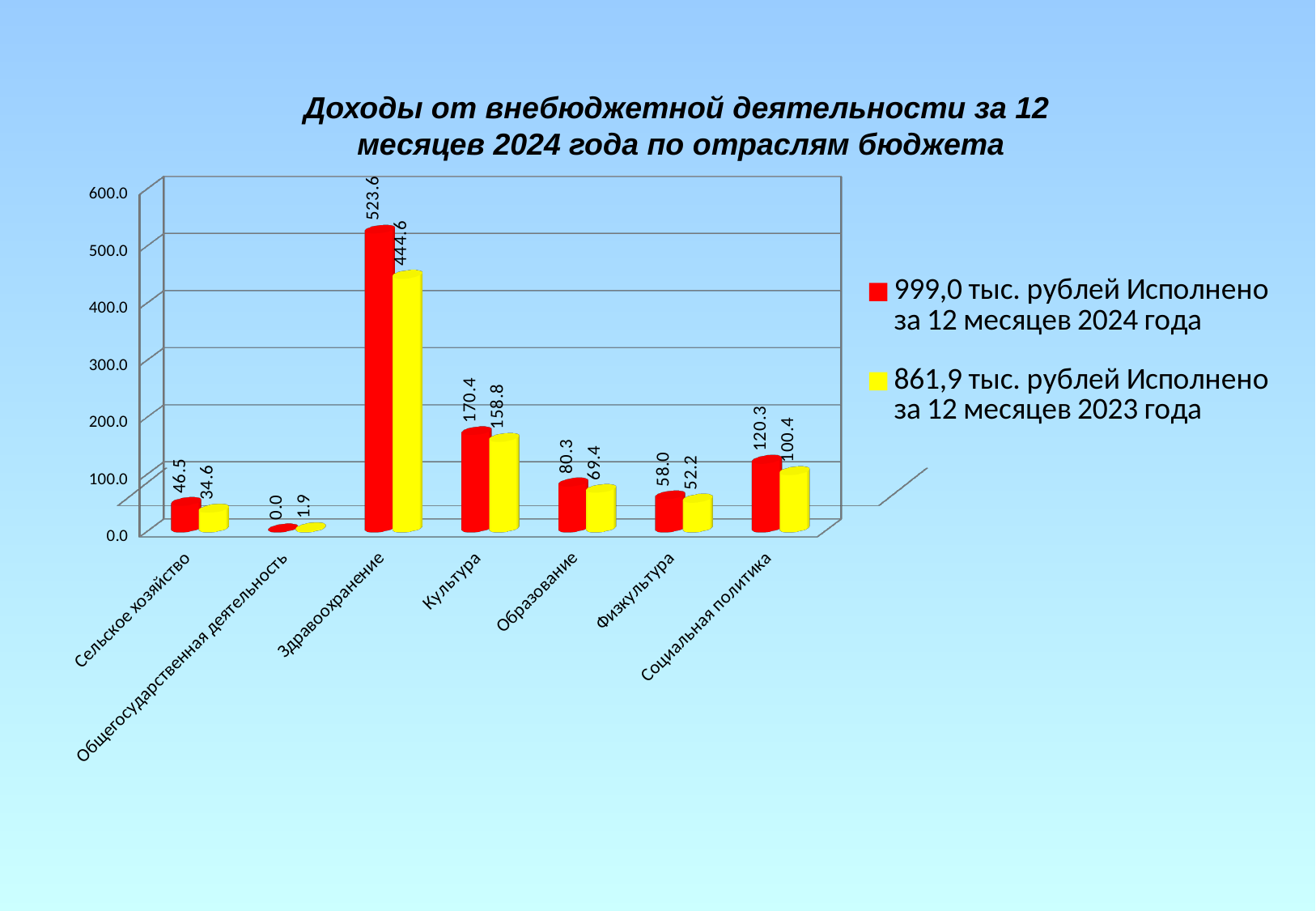
Which category has the highest value in the 2024 series? Здравоохранение How many categories are shown on the x axis? 7 Which category has the lowest value in the 2023 series? Общегосударственная деятельность Is the 2023 value for Здравоохранение greater or less than 400.0? greater How many series does the legend list? 2 What is the value for Здравоохранение in the series '999,0 тыс. рублей Исполнено за 12 месяцев 2024 года'? 523.6 What is the difference between the 2024 and 2023 values for Образование? 10.9 What is the value for Социальная политика in the 2024 series? 120.3 What kind of chart is shown on the slide? bar chart What is the difference between the 2024 and 2023 values for Здравоохранение? 79.0 Which is larger: the 2024 value for Физкультура or the 2024 value for Сельское хозяйство? Физкультура What is the value for Культура in the series '861,9 тыс. рублей Исполнено за 12 месяцев 2023 года'? 158.8